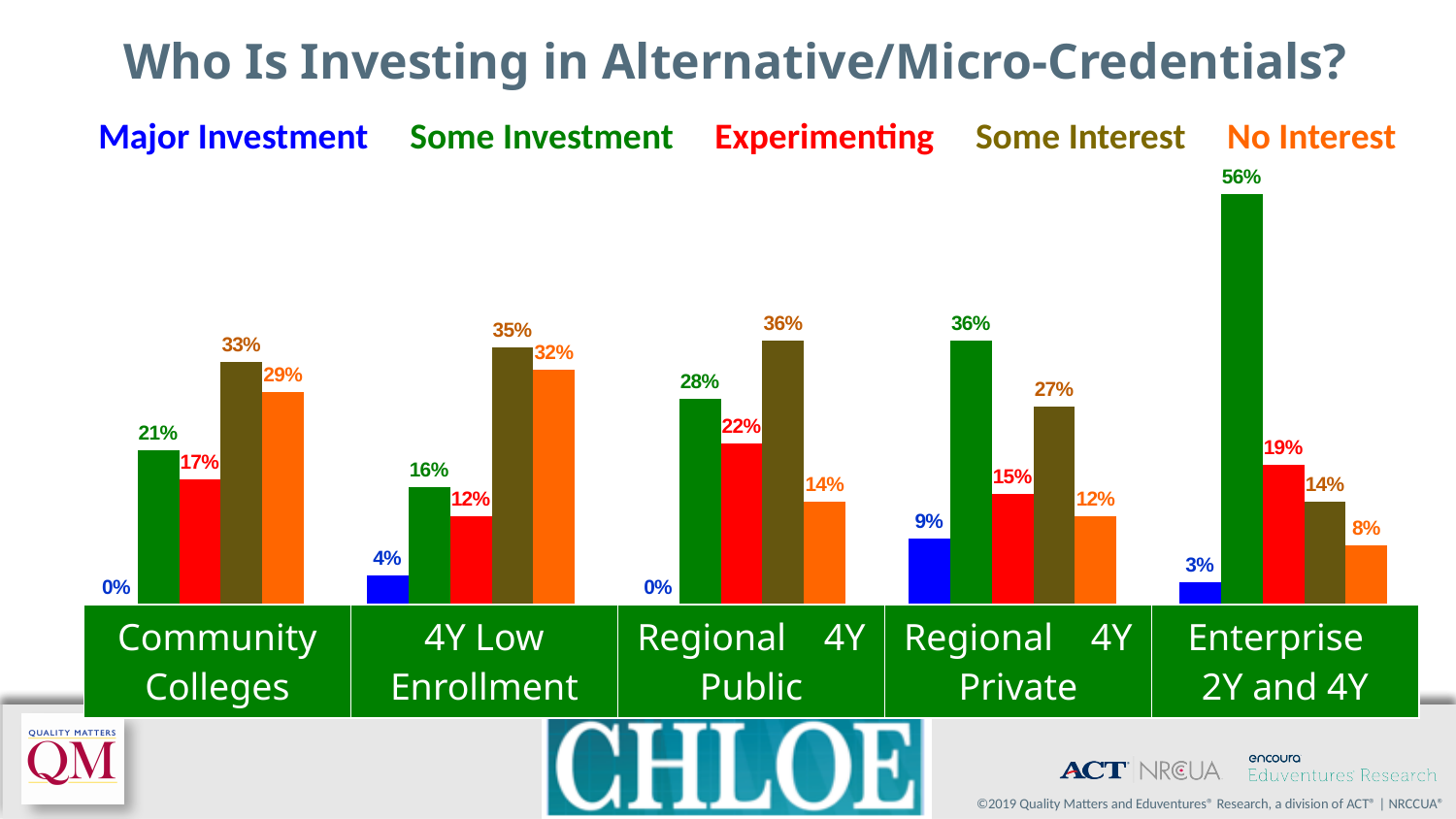
What is the difference between the Some Interest values for Regional 4Y Public and Regional 4Y Private? 9% Which is larger: the Experimenting value for Community Colleges or the Experimenting value for 4Y Low Enrollment? Community Colleges What is the Major Investment value for Regional 4Y Private? 9% Which category has the highest Some Investment value? Enterprise 2Y and 4Y How many series does the legend list? 5 What is the No Interest value for 4Y Low Enrollment? 32% What is the Experimenting value for Regional 4Y Public? 22% What kind of chart is shown on the slide? bar chart Which colour represents the Experimenting series in the legend? red Which category has the lowest No Interest value? Enterprise 2Y and 4Y How many institution categories are shown along the x axis? 5 What is the Some Investment value for Enterprise 2Y and 4Y? 56%